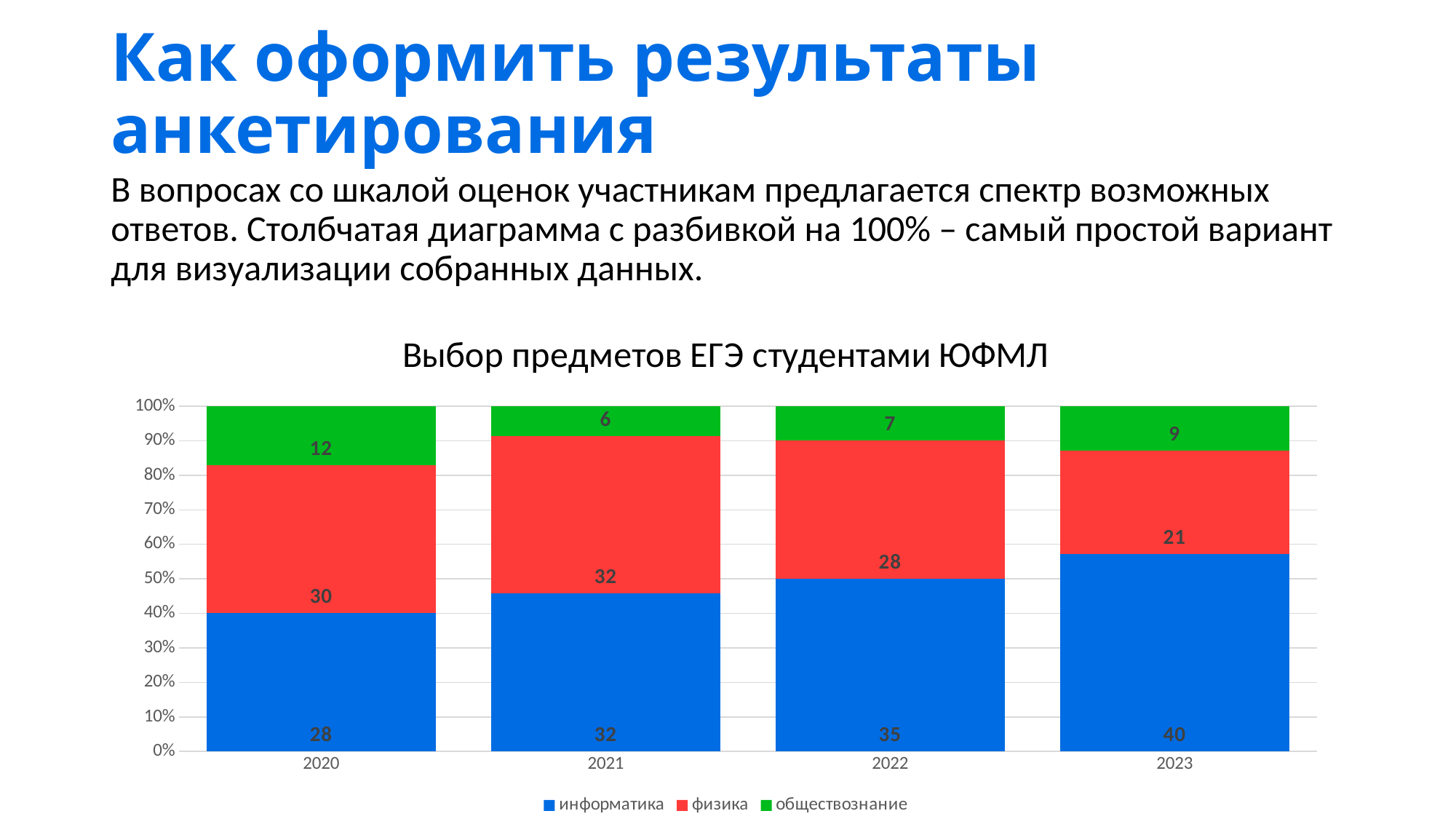
Do the values for информатика rise or fall from 2020 to 2023? rise How many series does the legend list? 3 What kind of chart is shown? 100% stacked bar chart In which year is the value for информатика highest? 2023 How many years are shown on the x axis? 4 In which year is the value for обществознание lowest? 2021 What is the value for обществознание in 2021? 6 What is the value for физика in 2020? 30 What is the total of the three data labels in the 2022 bar? 70 Which is larger: физика in 2021 or физика in 2023? физика in 2021 What is the value for информатика in 2023? 40 What is the difference between the информатика values for 2023 and 2020? 12